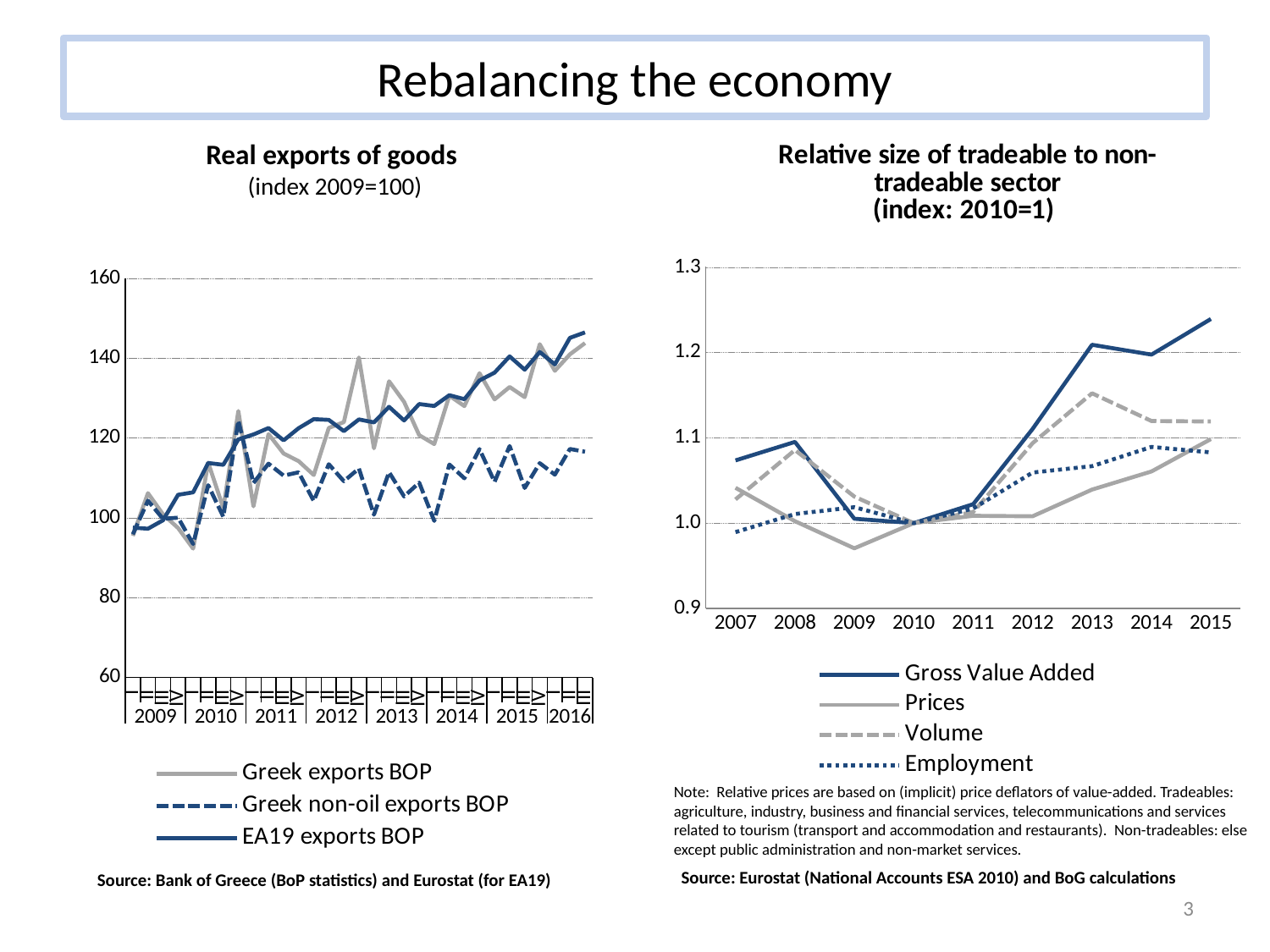
In the 'Relative size of tradeable to non-tradeable sector' chart, does Gross Value Added rise or fall from 2010 to 2015? Rise In the 'Relative size of tradeable to non-tradeable sector' chart, which series has the highest value in 2015? Gross Value Added What base year and value does the index in the 'Relative size of tradeable to non-tradeable sector' chart use? 2010=1 What kind of chart is the 'Relative size of tradeable to non-tradeable sector' chart? Line chart How many series does the legend of the 'Real exports of goods' chart list? 3 How many years are shown on the x axis of the 'Relative size of tradeable to non-tradeable sector' chart? 9 In the 'Real exports of goods' chart, is the value of EA19 exports BOP at the end of 2016 greater or less than 140? greater In the 'Relative size of tradeable to non-tradeable sector' chart, is the value of Prices in 2009 greater or less than 1.0? less What kind of chart is the 'Real exports of goods' chart? Line chart In the 'Relative size of tradeable to non-tradeable sector' chart, is the value of Gross Value Added in 2015 greater or less than 1.2? greater How many series does the legend of the 'Relative size of tradeable to non-tradeable sector' chart list? 4